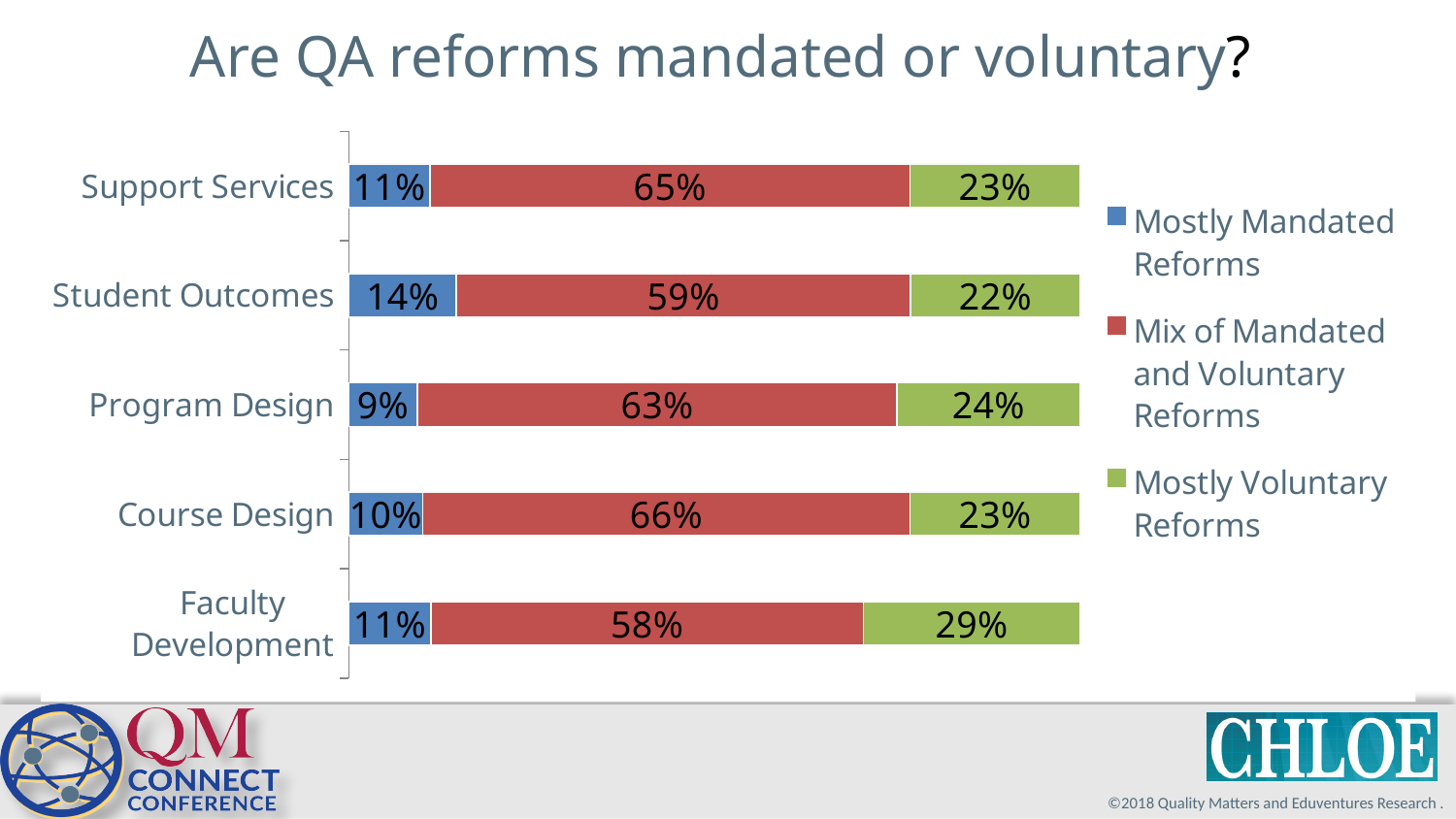
How many series does the legend list? 3 What percentage of Student Outcomes QA reforms are Mostly Mandated Reforms? 14% What kind of chart is shown on the slide? Stacked bar chart Which colour represents Mostly Voluntary Reforms in the chart? Green What is the title of the slide? Are QA reforms mandated or voluntary? Which category has the lowest share of Mostly Mandated Reforms? Program Design What percentage of Support Services QA reforms are Mix of Mandated and Voluntary Reforms? 65% Which is larger: the Mostly Voluntary Reforms share for Program Design or for Student Outcomes? Program Design What percentage of Faculty Development QA reforms are Mostly Voluntary Reforms? 29% How many categories are shown on the chart? 5 Which category has the highest share of Mostly Voluntary Reforms? Faculty Development What is the difference between the Mix of Mandated and Voluntary Reforms share for Course Design and for Faculty Development? 8%